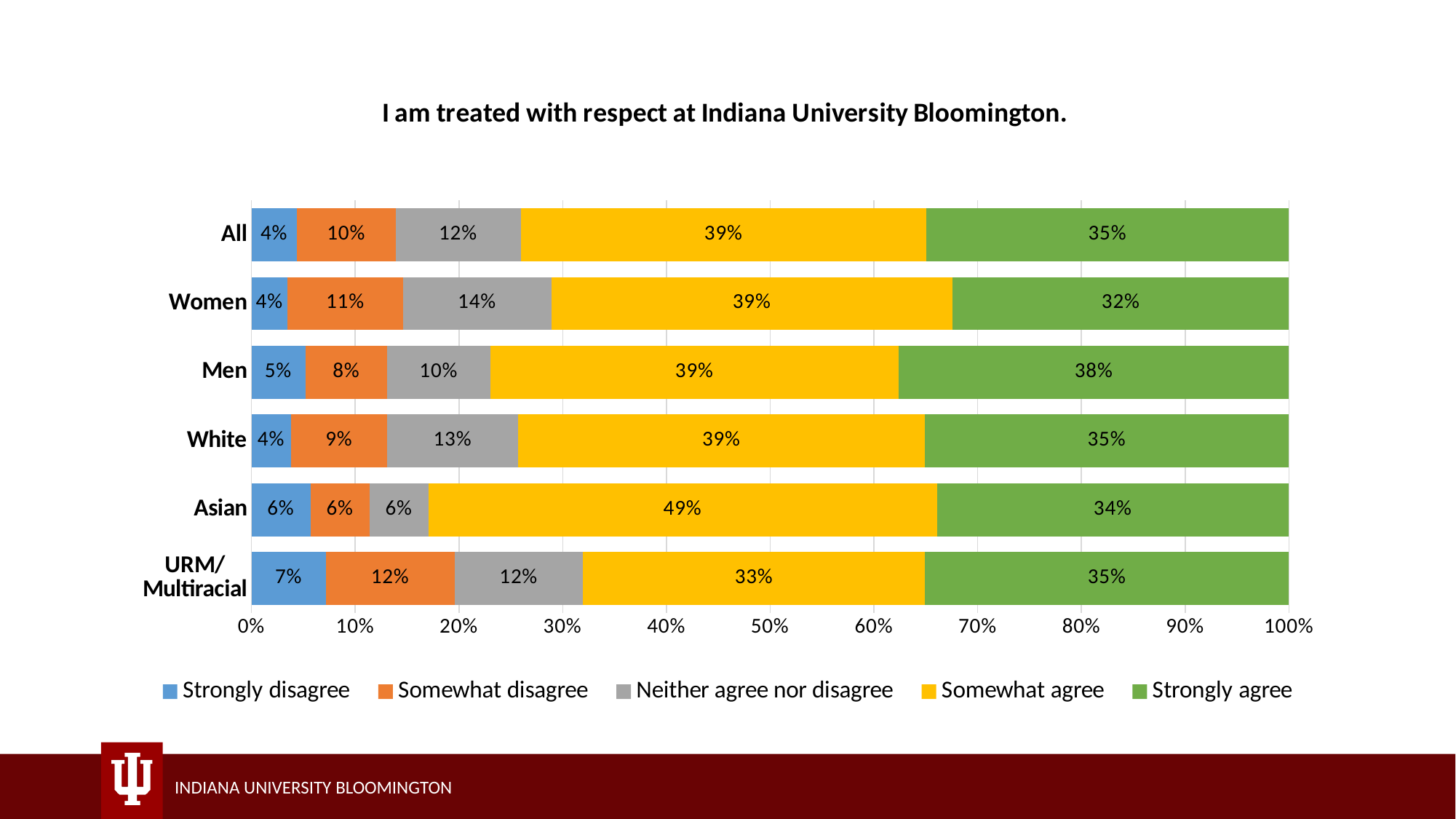
How many series does the legend list? 5 How many groups are shown on the chart? 6 What percentage of URM/Multiracial respondents strongly disagree? 7% Which is larger: the 'Somewhat disagree' percentage for Women or for Men? Women What percentage of Women neither agree nor disagree? 14% What is the title of the chart? I am treated with respect at Indiana University Bloomington. What percentage of Asian respondents somewhat agree that they are treated with respect? 49% What is the combined percentage of Asian respondents who somewhat agree or strongly agree? 83% What kind of chart is shown on the slide? Stacked bar chart What is the difference between the 'Strongly agree' percentages for Men and Women? 6% Which group has the highest 'Strongly agree' percentage? Men Which group has the lowest 'Somewhat agree' percentage? URM/Multiracial